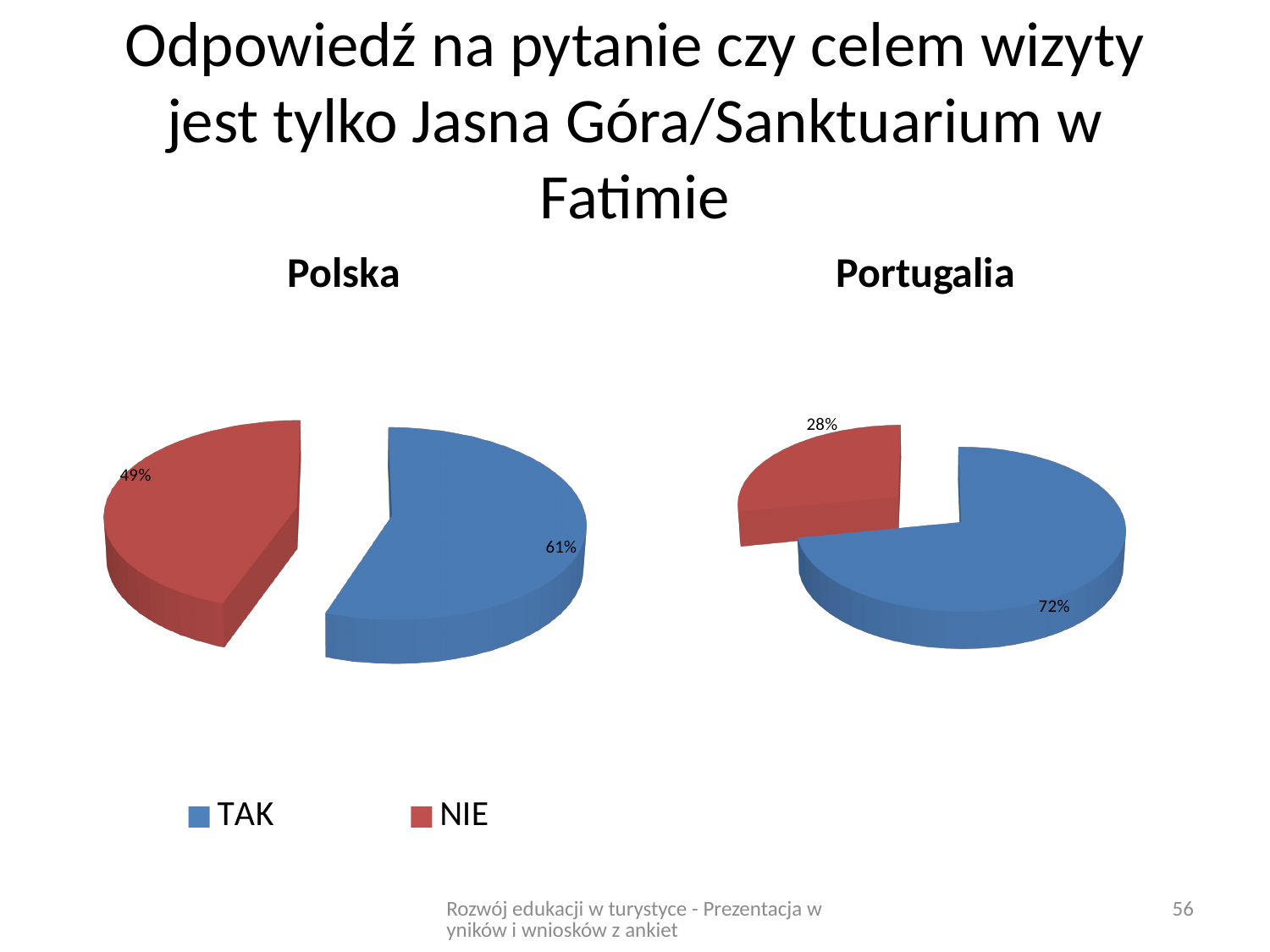
In the Portugalia pie chart, what percentage is shown for NIE? 28% In the Polska pie chart, what percentage is shown for TAK? 61% In the Portugalia pie chart, what is the difference between the TAK and NIE percentages? 44% Which chart shows a larger percentage for TAK, Polska or Portugalia? Portugalia In the Polska pie chart, what percentage is shown for NIE? 49% Which colour represents NIE in the legend? Red In the Polska pie chart, which is larger, TAK or NIE? TAK In the Portugalia pie chart, which answer has the smallest slice? NIE In the Portugalia pie chart, which answer has the largest slice? TAK What type of chart is used for Polska and Portugalia? Pie chart How many slices does the Portugalia pie chart have? 2 In the Portugalia pie chart, what percentage is shown for TAK? 72%